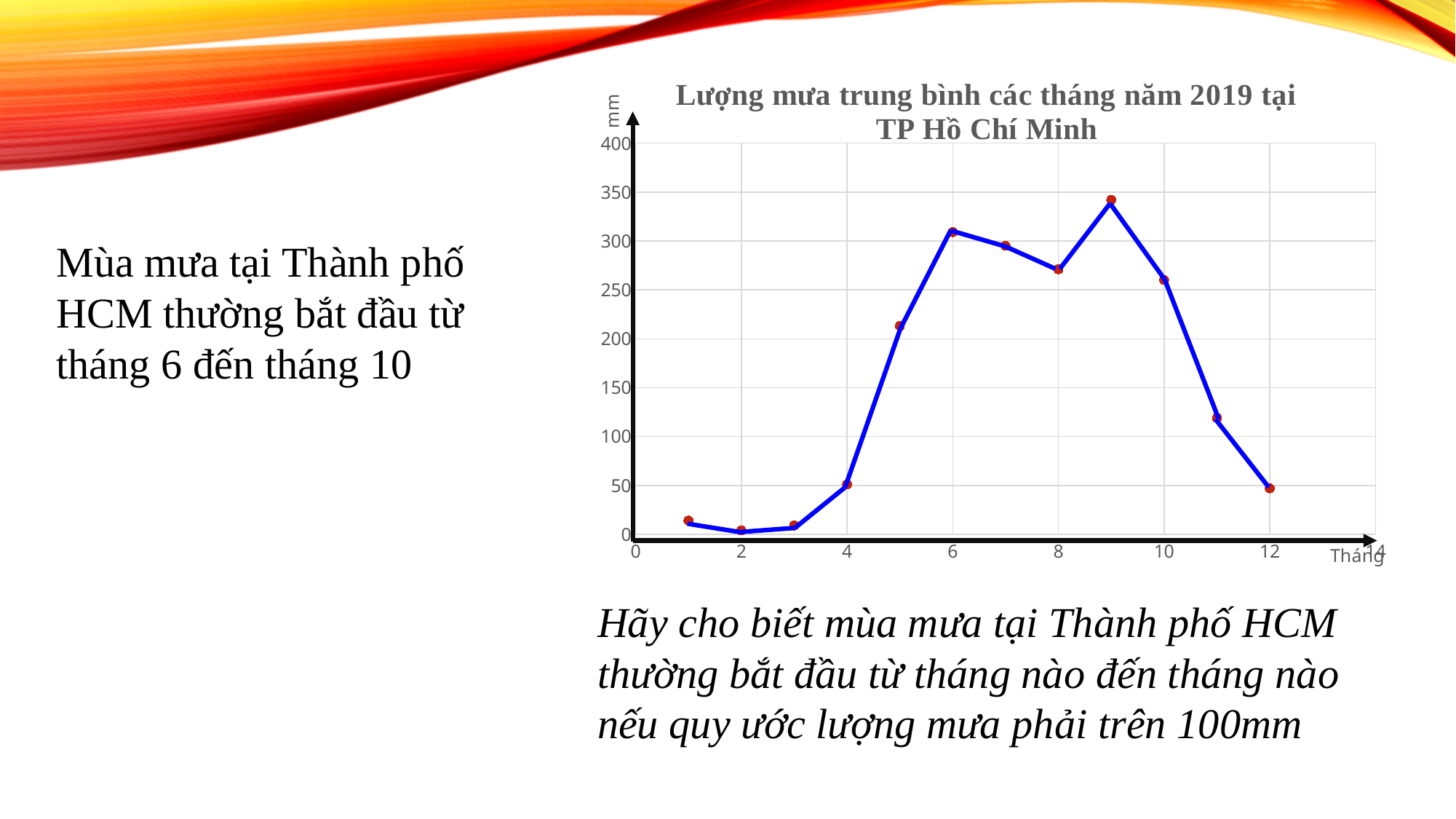
Which is larger, the value for month 5 or the value for month 10? month 10 What unit is shown on the vertical axis of the chart? mm Which is larger, the value for month 9 or the value for month 6? month 9 What kind of chart is shown on the slide? line chart Is the value for month 4 greater or less than 100? less What is the title of the chart? Lượng mưa trung bình các tháng năm 2019 tại TP Hồ Chí Minh Is the value for month 11 greater or less than 100? greater Which month has the highest rainfall value on the chart? 9 Do the values rise or fall from month 9 to month 12? fall How many data points are plotted on the line? 12 Is the value for month 9 greater or less than 300? greater